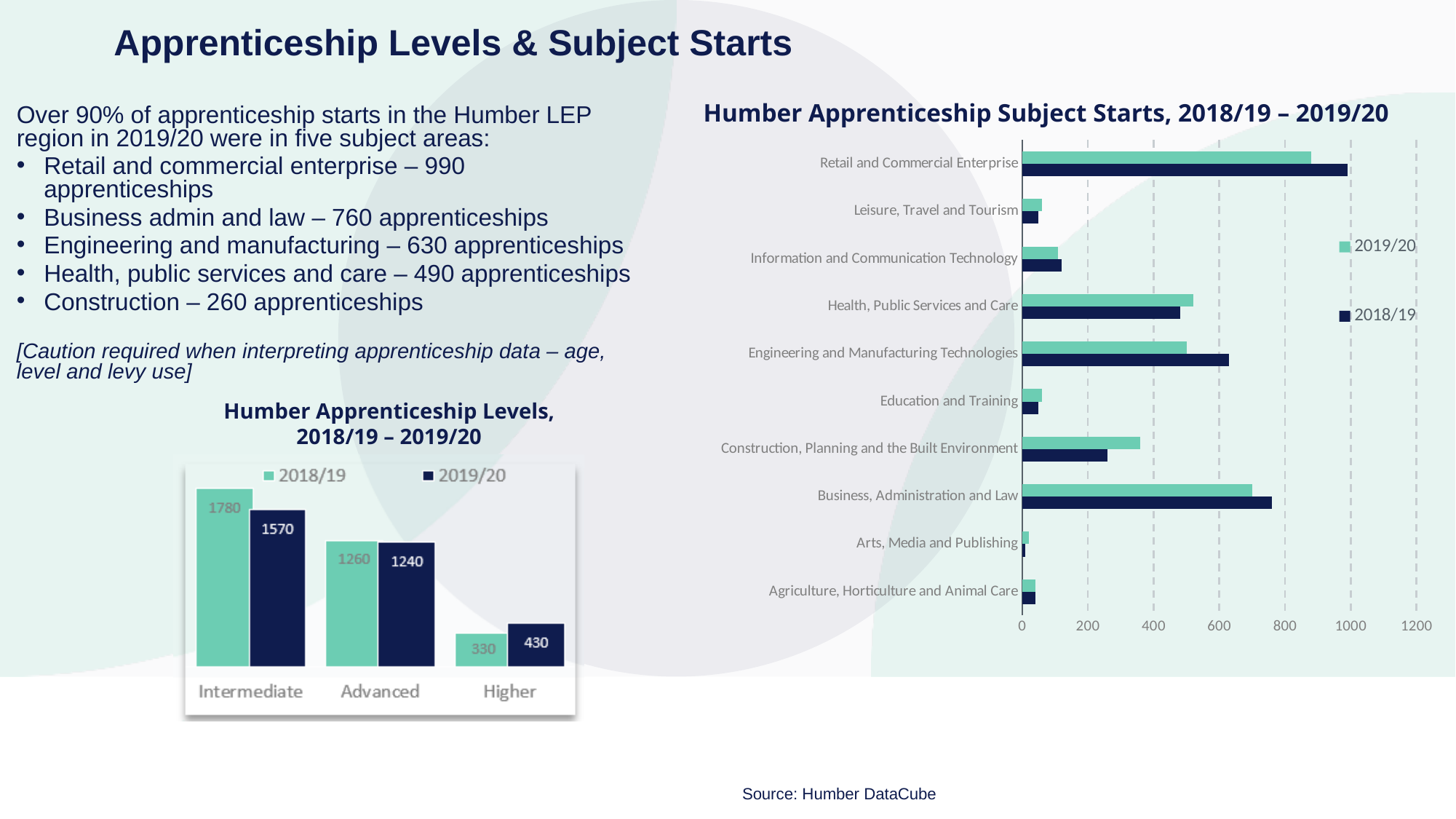
In the Humber Apprenticeship Subject Starts chart, is the value for Leisure, Travel and Tourism in the 2019/20 series greater or less than 200? less In the Humber Apprenticeship Levels chart, what is the 2019/20 value for Advanced? 1240 In the Humber Apprenticeship Levels chart, what is the 2018/19 value for Intermediate? 1780 In the Humber Apprenticeship Levels chart, what is the difference between the 2018/19 and 2019/20 values for Intermediate? 210 In the Humber Apprenticeship Subject Starts chart, how many series does the legend list? 2 In the Humber Apprenticeship Levels chart, what is the 2019/20 value for Higher? 430 In the Humber Apprenticeship Levels chart, how many levels are shown on the x axis? 3 In the Humber Apprenticeship Levels chart, which level has the lowest 2018/19 value? Higher In the Humber Apprenticeship Levels chart, which is larger for Higher: the 2018/19 value or the 2019/20 value? 2019/20 In the Humber Apprenticeship Subject Starts chart, which subject area has the longest bars? Retail and Commercial Enterprise What kind of chart is the Humber Apprenticeship Subject Starts chart? Bar chart In the Humber Apprenticeship Subject Starts chart, how many subject areas are listed? 10